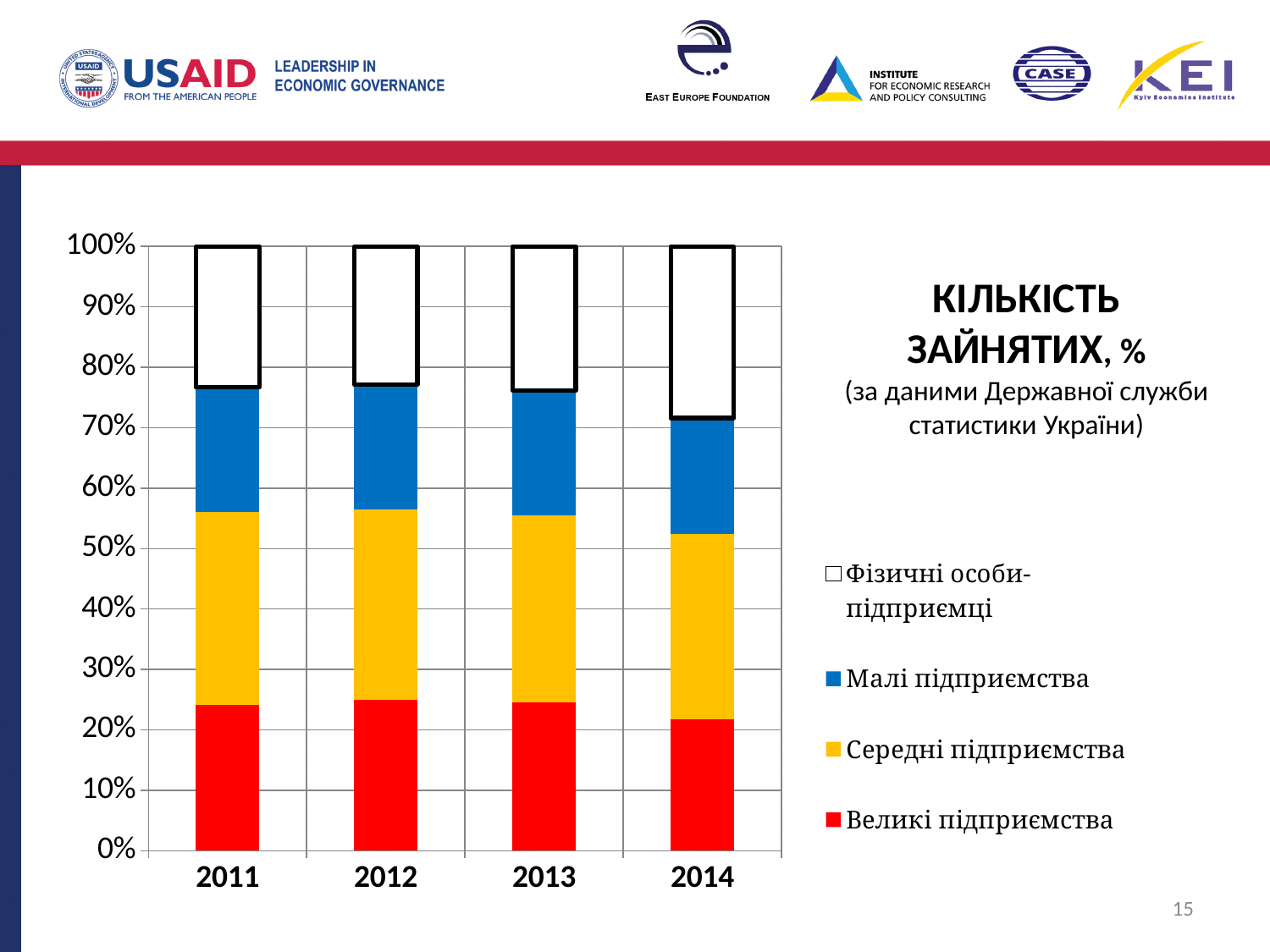
What is the title of the chart? КІЛЬКІСТЬ ЗАЙНЯТИХ, % What is the total of the stacked bar for 2013? 100% In 2011, which is larger: the share of Середні підприємства or the share of Великі підприємства? Середні підприємства How many years are shown on the x axis of the chart? 4 Is the value for Великі підприємства in 2011 greater or less than 20%? greater What kind of chart is shown on the slide? Stacked bar chart Is the value for Великі підприємства in 2012 greater or less than 20%? greater Is the value for Великі підприємства in 2014 greater or less than 30%? less Is the share of Фізичні особи-підприємці larger in 2011 or in 2014? 2014 In which year is the share of Великі підприємства the lowest? 2014 Which colour represents Великі підприємства in the chart? Red How many series does the chart legend list? 4